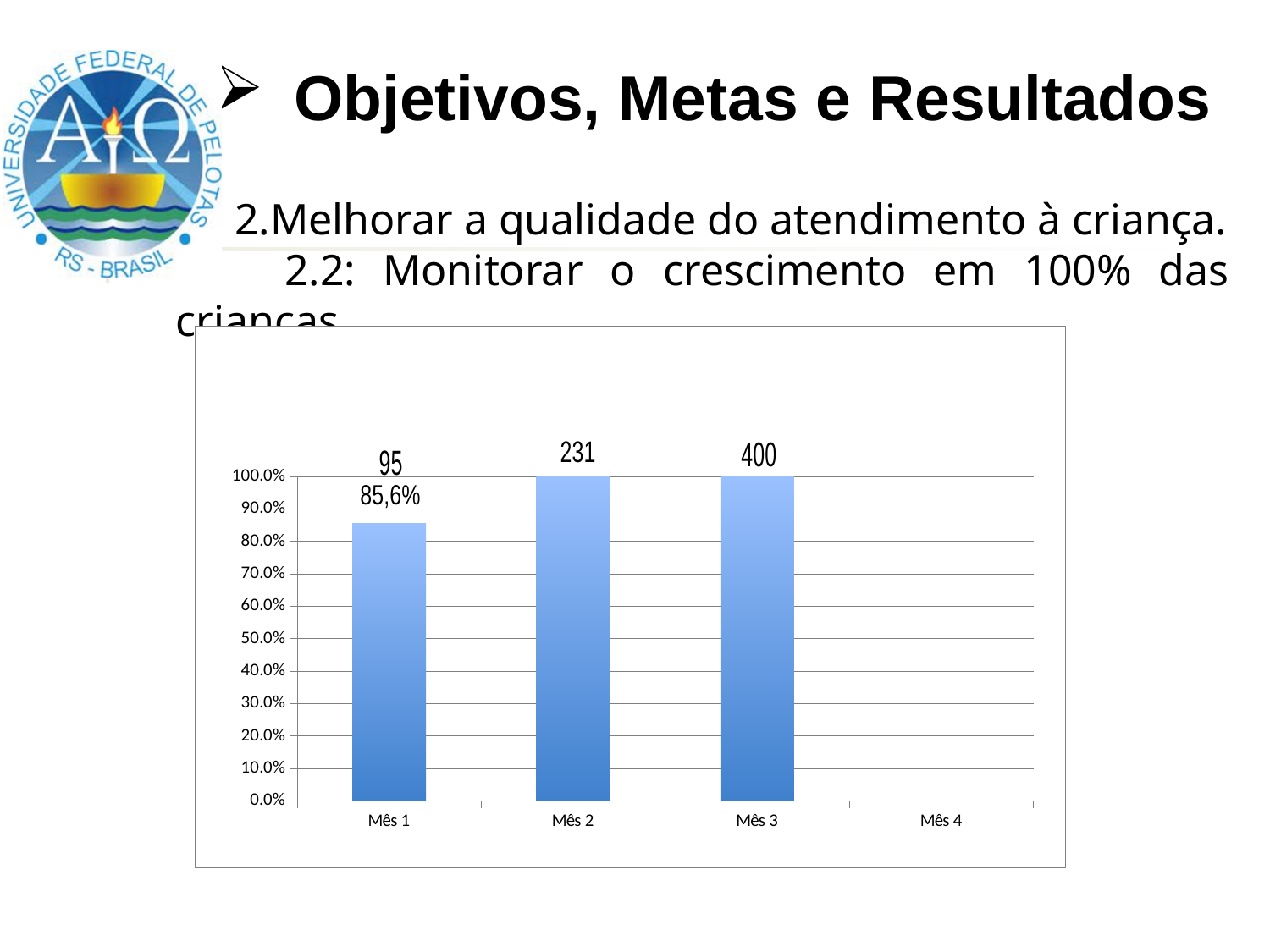
Which category has the lowest value? Mês 4 Does the value rise or fall from Mês 1 to Mês 2? rise What number is printed above the bar for Mês 2? 231 What number is printed above the bar for Mês 3? 400 Which is larger, the value for Mês 1 or the value for Mês 2? Mês 2 What is the value for Mês 3? 100.0% What is the value for Mês 2? 100.0% Is the value for Mês 4 greater or less than 10.0%? less What kind of chart is shown on the slide? Bar chart How many categories are shown on the x axis? 4 Is the value for Mês 1 greater or less than 80.0%? greater What is the value for Mês 1? 85,6%